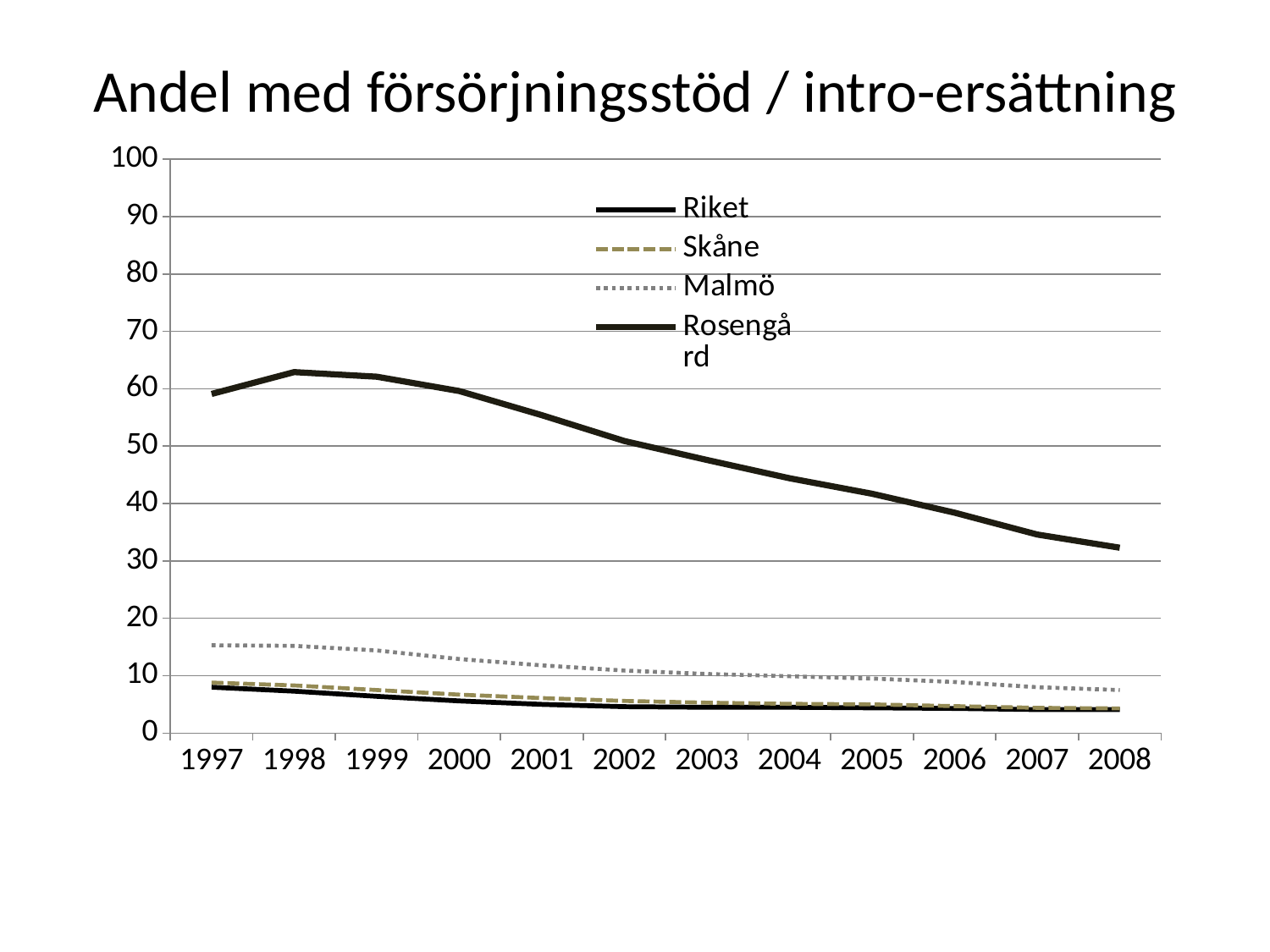
What kind of chart is shown on the slide? line chart Does the Malmö series rise or fall from 1997 to 2008? fall Is the value for Rosengård in 1998 greater or less than 60? greater Which series has the highest values across all years? Rosengård Which series is drawn with a dotted line? Malmö Is the value for Riket in 2008 greater or less than 10? less How many years are shown on the x axis? 12 Is the value for Rosengård in 2008 greater or less than 40? less What is the title of the chart? Andel med försörjningsstöd / intro-ersättning How many series does the legend list? 4 Which is larger in 2000, the value for Malmö or the value for Riket? Malmö